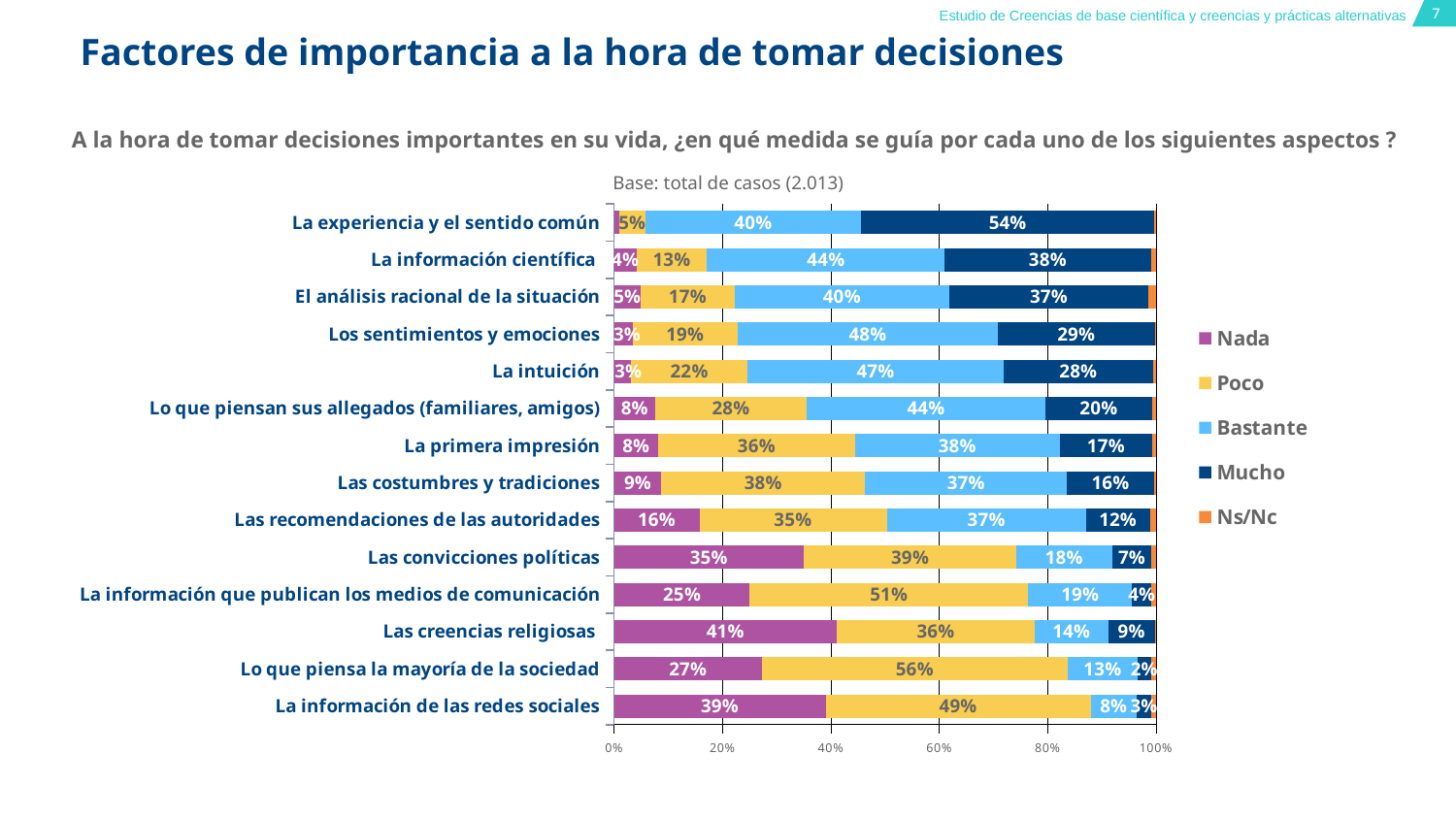
What is the difference between the "Mucho" values for "La información científica" and "La intuición"? 10 percentage points What is the "Nada" value for "Las creencias religiosas"? 41% What is the "Bastante" value for "Los sentimientos y emociones"? 48% What percentage of respondents answered "Mucho" for "La experiencia y el sentido común"? 54% Which has a larger "Nada" value: "Las convicciones políticas" or "La información de las redes sociales"? La información de las redes sociales How many series does the legend list? 5 What kind of chart is shown on the slide? Stacked bar chart Which category has the lowest "Mucho" value? Lo que piensa la mayoría de la sociedad Which category has the highest "Mucho" value? La experiencia y el sentido común How many categories (aspects) are shown in the chart? 14 What is the "Poco" value for "Lo que piensa la mayoría de la sociedad"? 56% What base (number of cases) is stated above the chart? 2.013